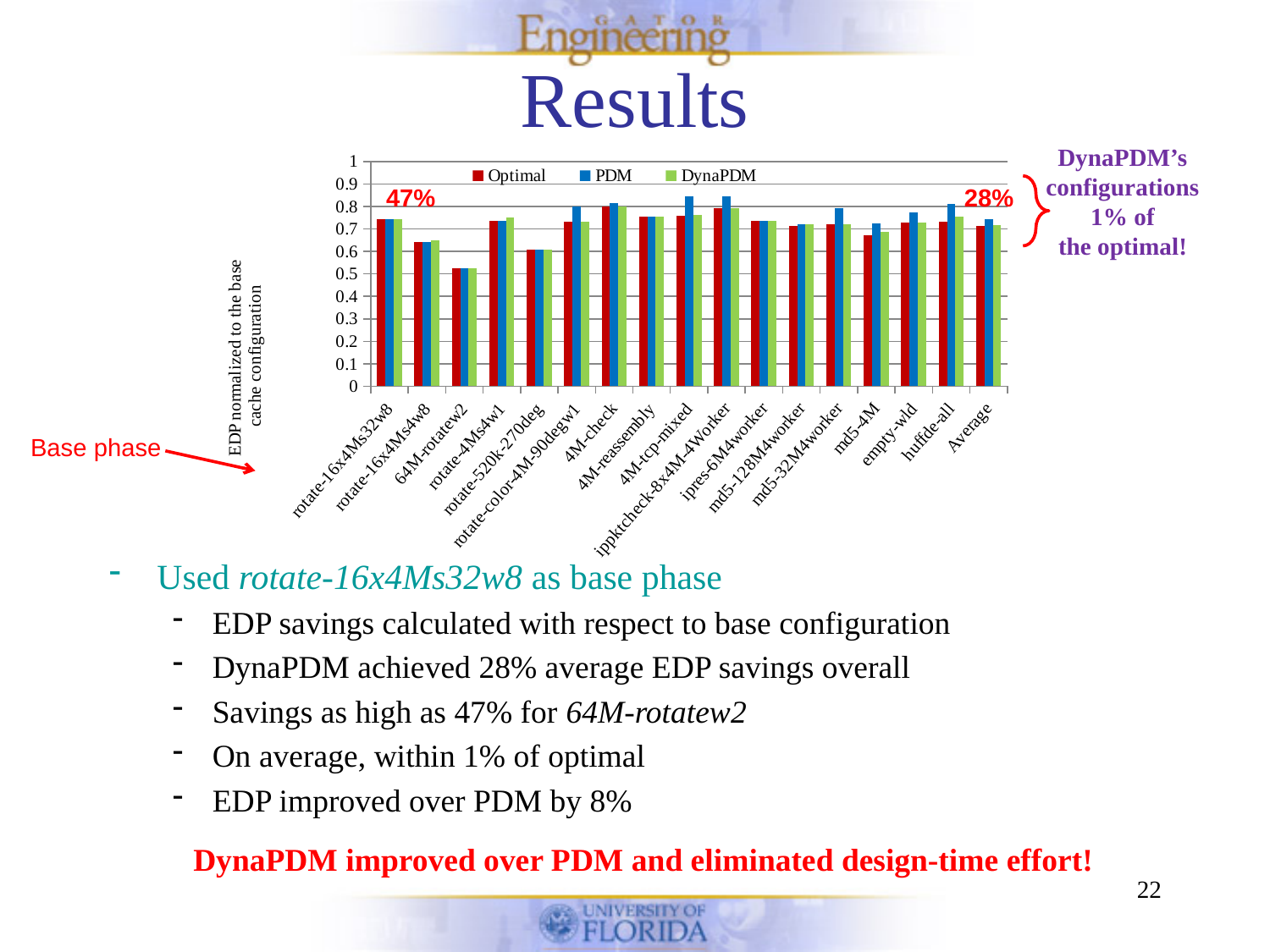
What is the label on the chart's y axis? EDP normalized to the base cache configuration Is the PDM value for 4M-tcp-mixed greater or less than 0.8? greater Which has the larger DynaPDM value: 64M-rotatew2 or 4M-check? 4M-check Is the Optimal value for rotate-16x4Ms32w8 greater or less than 0.7? greater Is the DynaPDM value for rotate-16x4Ms4w8 greater or less than 0.6? greater What kind of chart is shown on the slide? bar chart Which category has the lowest DynaPDM value in the chart? 64M-rotatew2 How many categories are shown along the x axis of the chart? 17 Which has the larger PDM value: rotate-16x4Ms4w8 or 4M-tcp-mixed? 4M-tcp-mixed How many series does the chart's legend list? 3